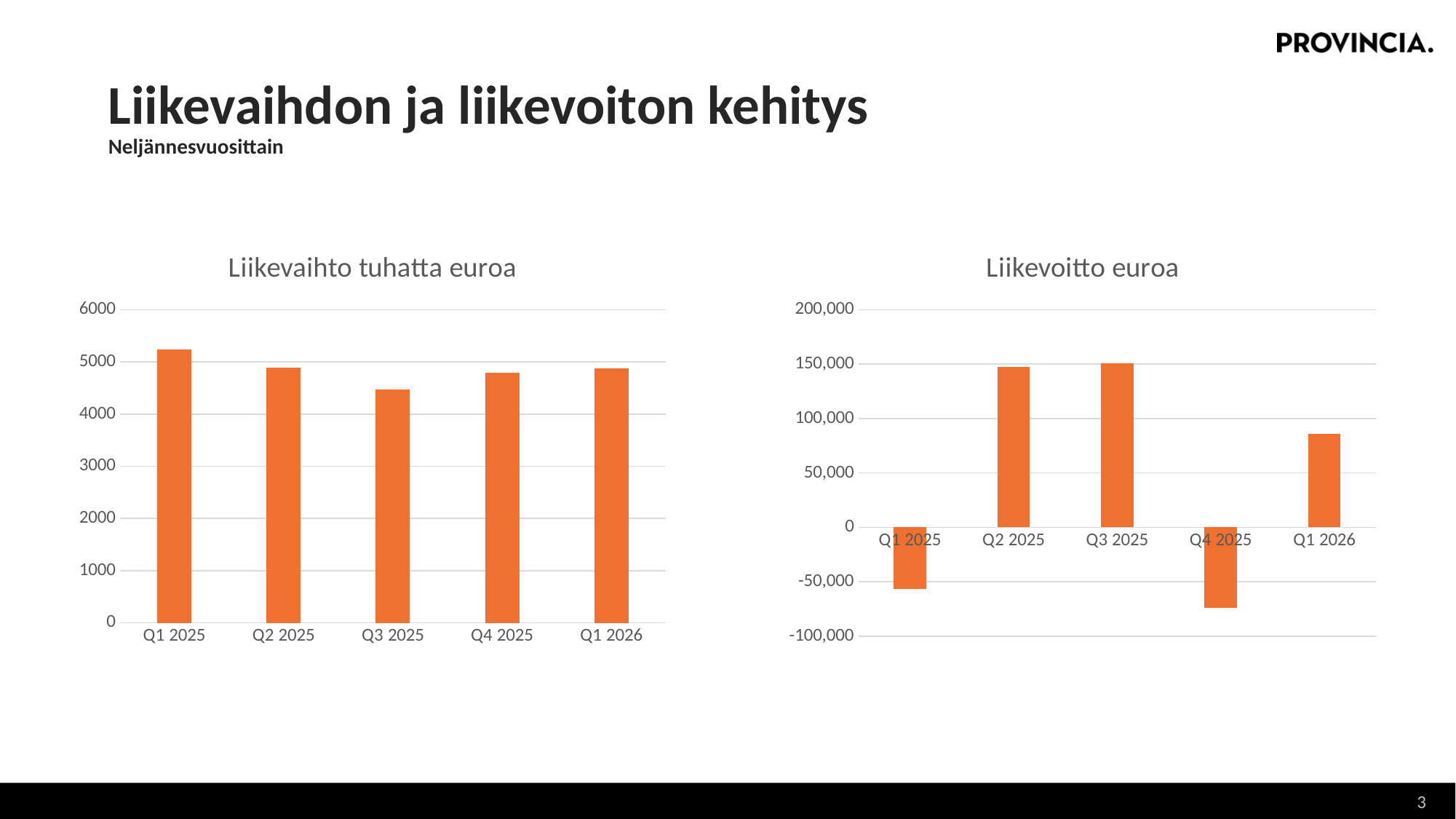
In the 'Liikevaihto tuhatta euroa' chart, which quarter has the lowest value? Q3 2025 In the 'Liikevaihto tuhatta euroa' chart, which is larger, the value for Q2 2025 or Q3 2025? Q2 2025 In the 'Liikevoitto euroa' chart, which quarter has the lowest value? Q4 2025 How many quarters are shown in the 'Liikevaihto tuhatta euroa' chart? 5 What kind of chart is the 'Liikevoitto euroa' chart? bar chart In the 'Liikevoitto euroa' chart, is the value for Q4 2025 greater or less than -50,000? less In the 'Liikevoitto euroa' chart, which is larger, the value for Q2 2025 or Q1 2026? Q2 2025 In the 'Liikevaihto tuhatta euroa' chart, is the value for Q1 2025 greater or less than 5000? greater In the 'Liikevoitto euroa' chart, is the value for Q1 2026 greater or less than 100,000? less What is the title of the chart on the right side of the slide? Liikevoitto euroa In the 'Liikevaihto tuhatta euroa' chart, which quarter has the highest value? Q1 2025